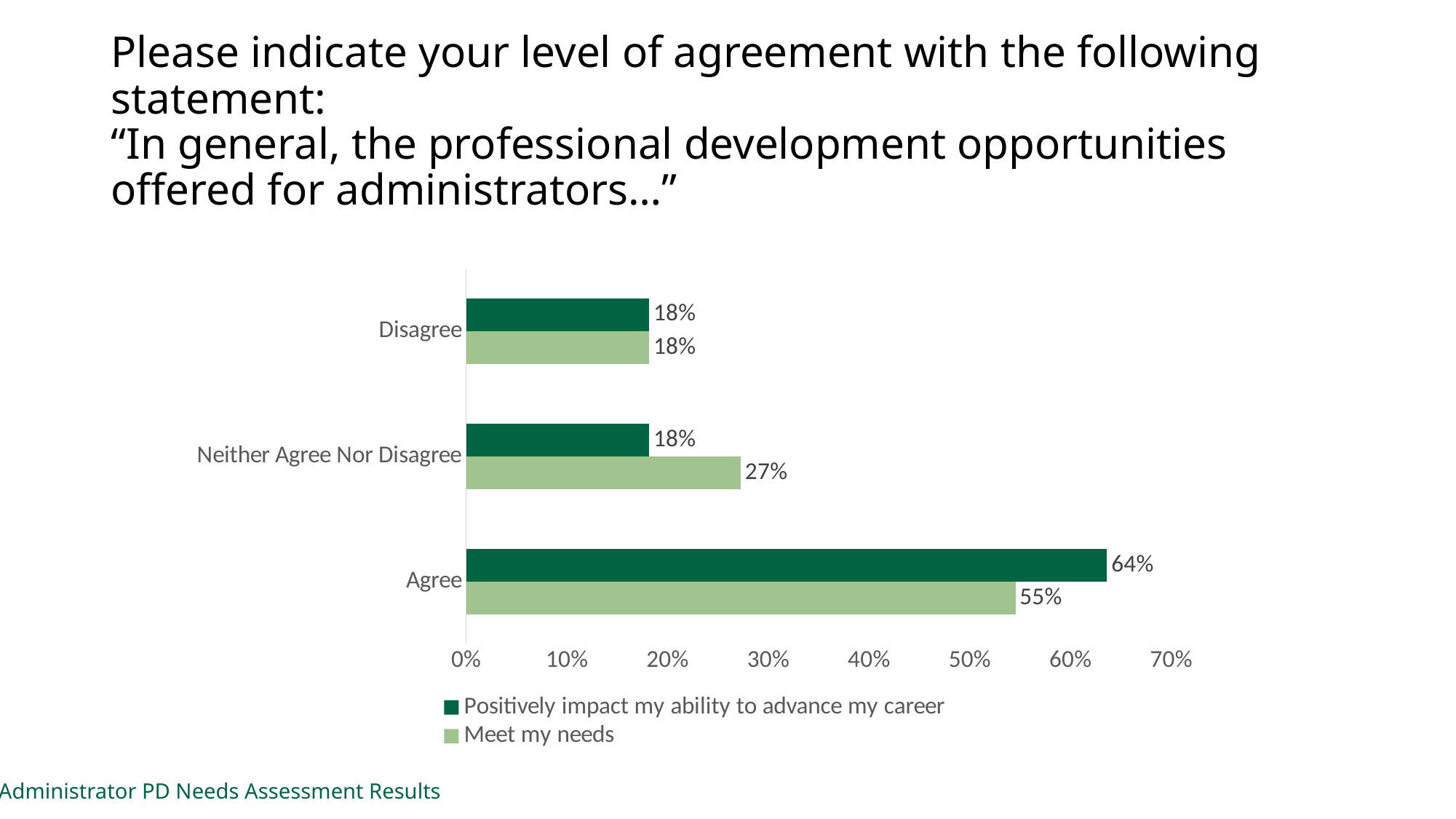
What is the value for 'Positively impact my ability to advance my career' in the Disagree category? 18% What is the value for 'Meet my needs' in the Neither Agree Nor Disagree category? 27% What percentage of respondents agree that professional development opportunities meet their needs? 55% In the Neither Agree Nor Disagree category, which series has the larger value? Meet my needs How many series does the legend list? 2 What percentage of respondents agree that professional development opportunities positively impact their ability to advance their career? 64% What is the difference between the 'Meet my needs' values for Neither Agree Nor Disagree and Disagree? 9% What is the highest value shown on the x axis? 70% Which category has the highest value for the 'Meet my needs' series? Agree What is the difference between the Agree values for 'Positively impact my ability to advance my career' and 'Meet my needs'? 9% What kind of chart is shown on the slide? Bar chart How many response categories are shown on the chart? 3